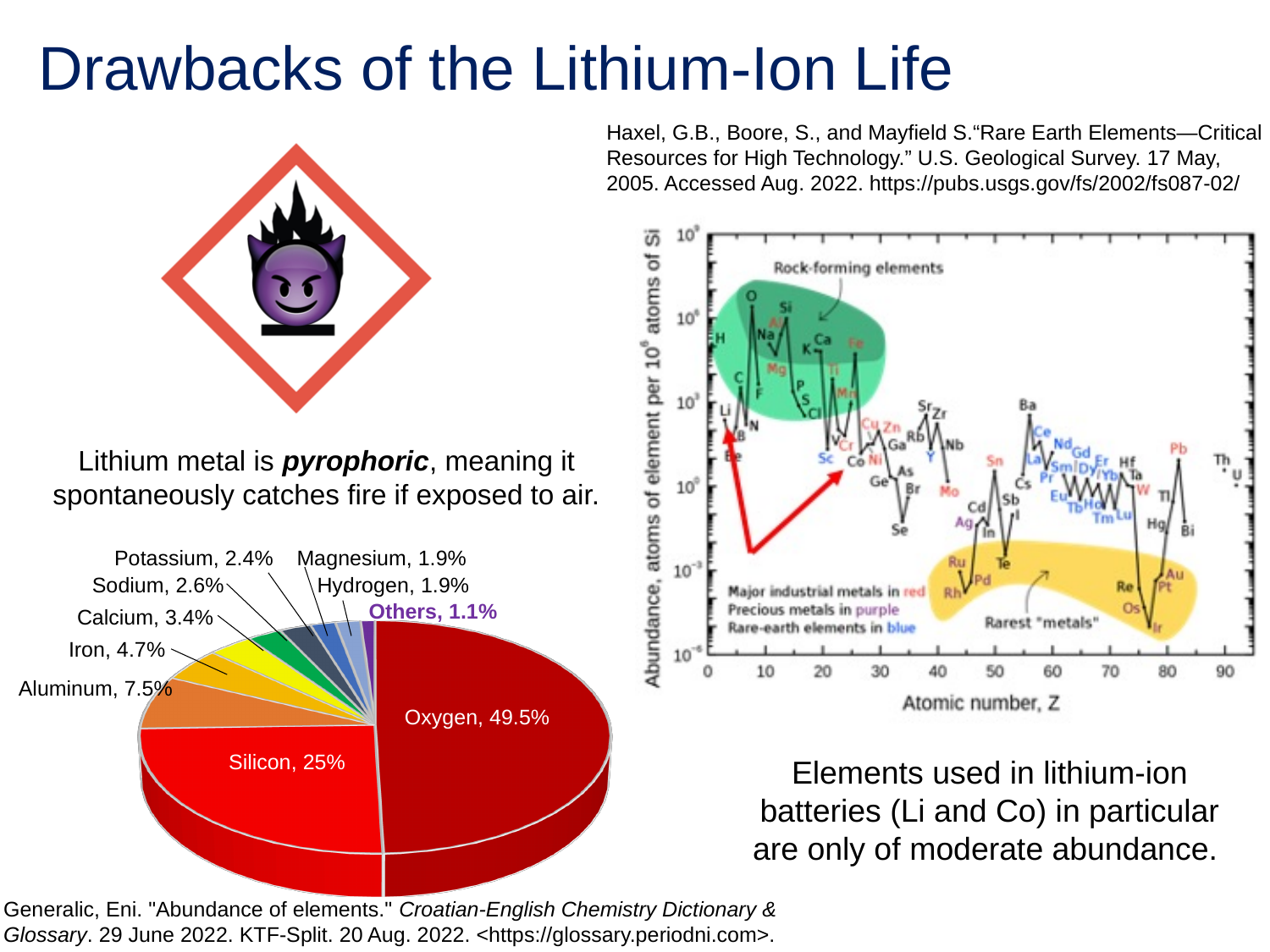
On the pie chart at the bottom left, how many slices are labelled? 10 On the pie chart at the bottom left, what share is labelled for Silicon? 25% On the pie chart at the bottom left, what share is labelled for Oxygen? 49.5% On the pie chart at the bottom left, what share is labelled for Iron? 4.7% On the pie chart at the bottom left, what is the combined share of Magnesium and Hydrogen? 3.8% On the pie chart at the bottom left, which labelled slice is the smallest? Others, 1.1% On the pie chart at the bottom left, which is larger, the Calcium slice or the Sodium slice? Calcium What kind of chart is shown at the bottom left of the slide? Pie chart On the pie chart at the bottom left, what share is labelled for Aluminum? 7.5% On the chart on the right side of the slide, what is the label of the horizontal axis? Atomic number, Z On the pie chart at the bottom left, what is the difference between the Oxygen and Silicon shares? 24.5% On the pie chart at the bottom left, which element has the largest slice? Oxygen